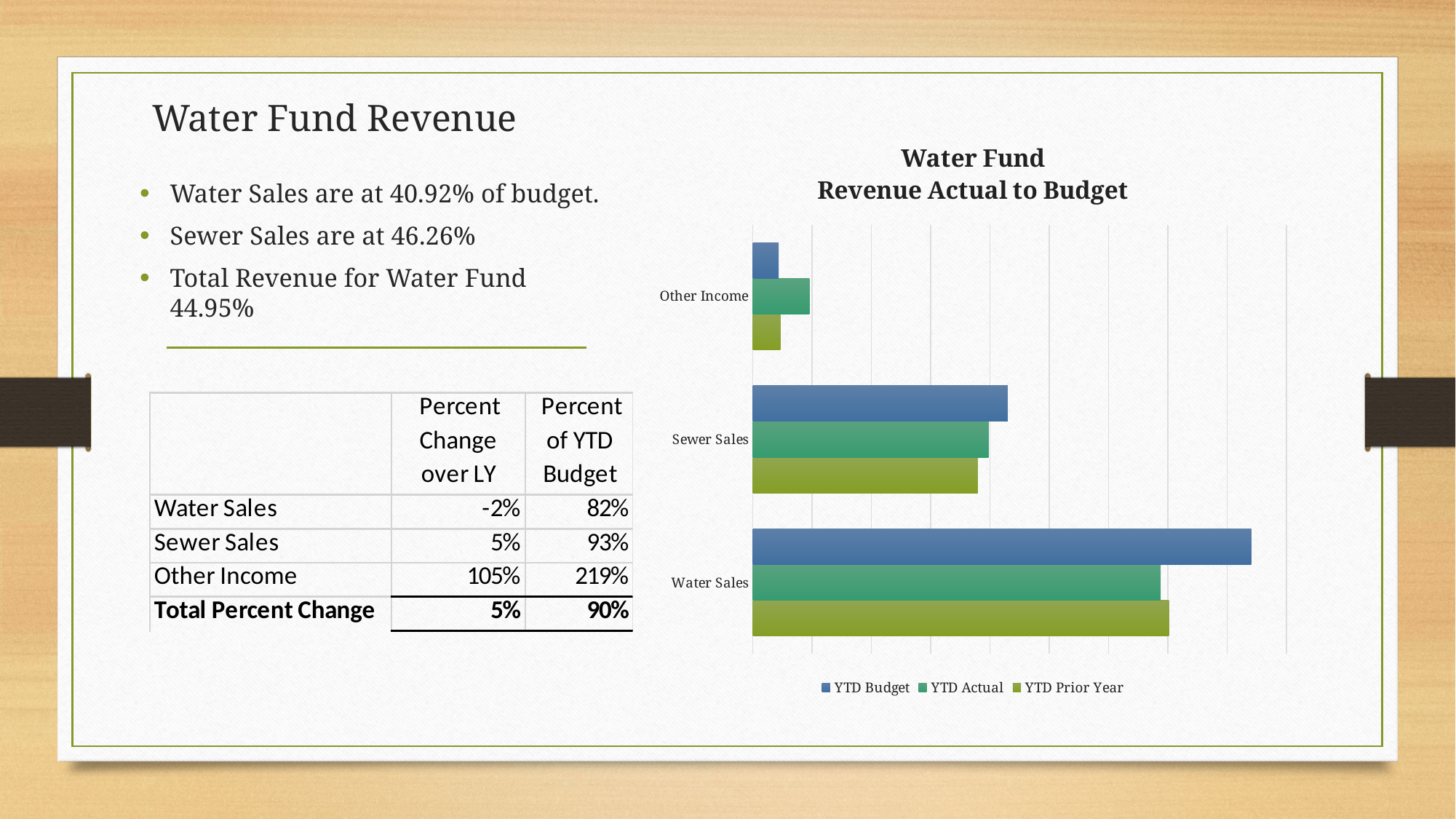
Which series is shown in blue in the chart legend? YTD Budget What kind of chart is shown on the slide? bar chart How many categories are plotted on the chart? 3 What is the title of the chart? Water Fund Revenue Actual to Budget For Water Sales, which is larger: YTD Budget or YTD Actual? YTD Budget How many series does the chart legend list? 3 For Sewer Sales, which is larger: YTD Budget or YTD Actual? YTD Budget Which category has the shortest YTD Prior Year bar? Other Income For Other Income, which is larger: YTD Budget or YTD Actual? YTD Actual Which category has the longest YTD Budget bar? Water Sales Which category has the shortest YTD Actual bar? Other Income